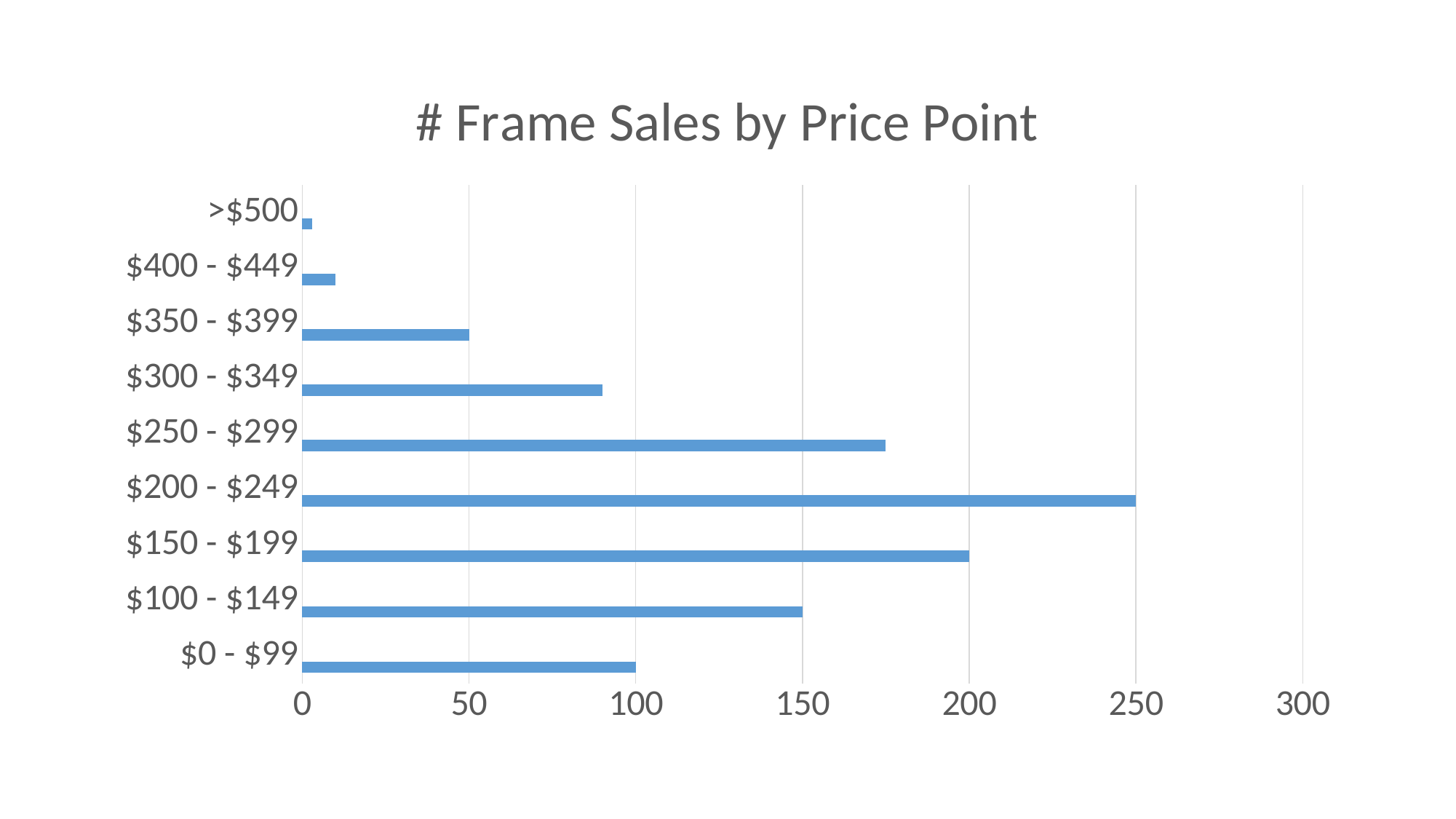
Which price point has the highest number of frame sales? $200 - $249 How many price point categories are shown in the chart? 9 What is the title of the chart? # Frame Sales by Price Point What kind of chart is shown on the slide? bar chart Is the value for $400 - $449 greater or less than 50? less What is the number of frame sales for the $350 - $399 price point? 50 What is the number of frame sales for the $0 - $99 price point? 100 Which price point has the lowest number of frame sales? >$500 Is the value for $250 - $299 greater or less than 150? greater What is the difference in frame sales between the $200 - $249 and $150 - $199 price points? 50 What is the number of frame sales for the $200 - $249 price point? 250 Which has more frame sales, the $100 - $149 price point or the $300 - $349 price point? $100 - $149